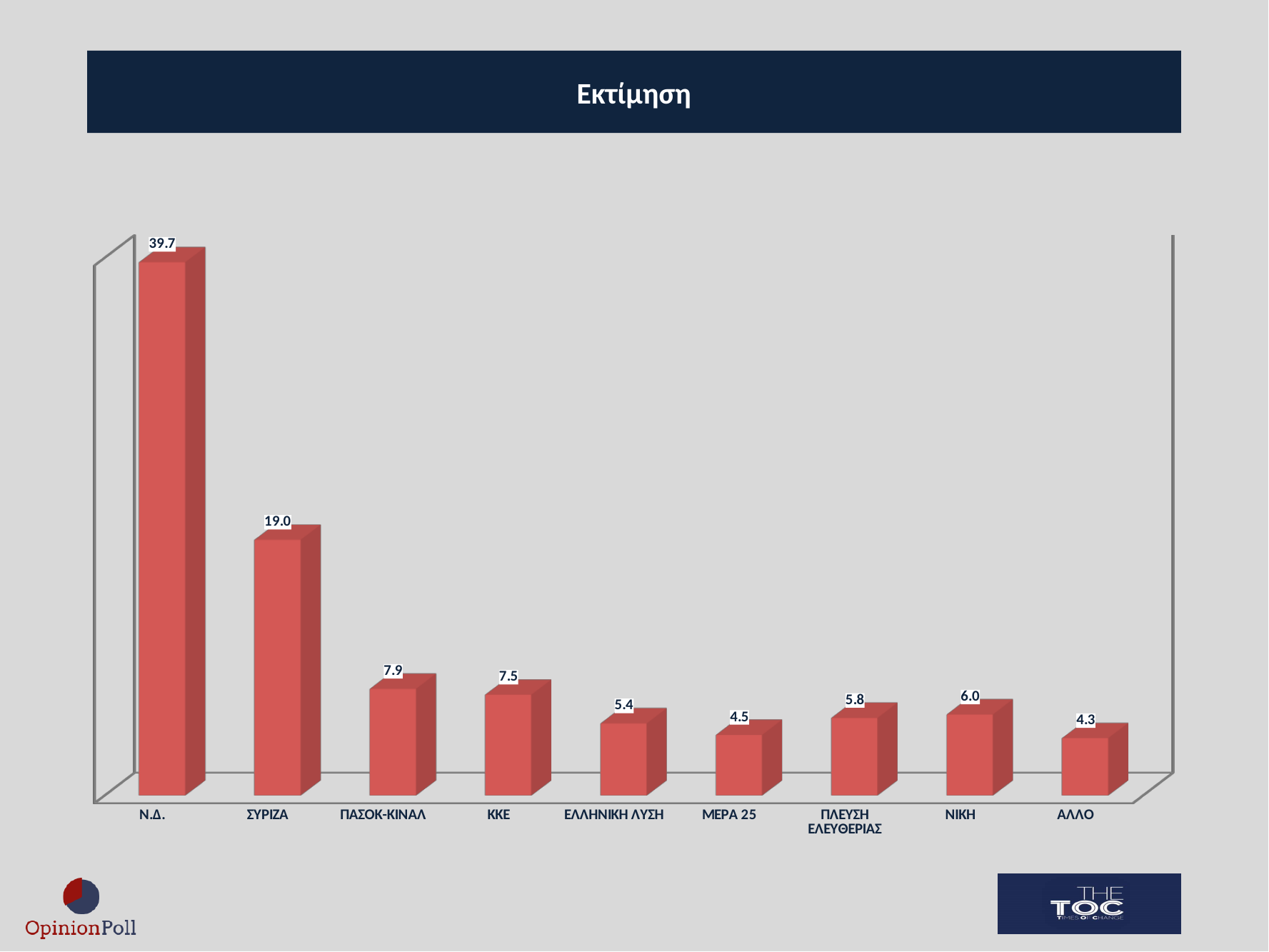
What is the title of the chart? Εκτίμηση Which category has the lowest value? ΑΛΛΟ What is the value for Ν.Δ.? 39.7 What kind of chart is shown on the slide? Bar chart What is the value for ΑΛΛΟ? 4.3 Which has a larger value, ΝΙΚΗ or ΕΛΛΗΝΙΚΗ ΛΥΣΗ? ΝΙΚΗ What is the difference between the values for Ν.Δ. and ΣΥΡΙΖΑ? 20.7 Which category has the highest value? Ν.Δ. What is the difference between the values for ΠΑΣΟΚ-ΚΙΝΑΛ and ΚΚΕ? 0.4 What is the value for ΣΥΡΙΖΑ? 19.0 What is the value for ΠΛΕΥΣΗ ΕΛΕΥΘΕΡΙΑΣ? 5.8 How many categories are shown on the chart? 9